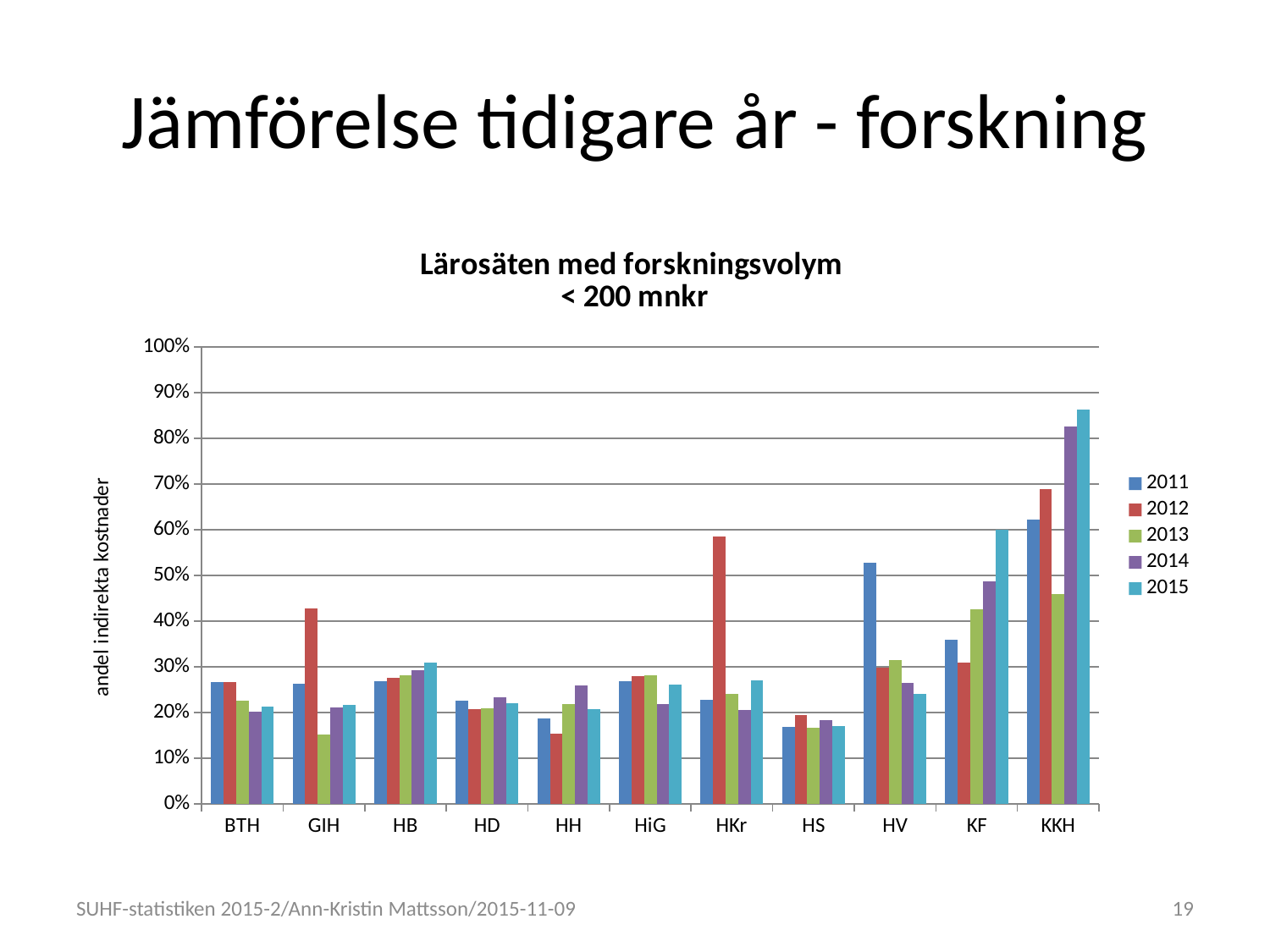
Is the value for HKr in 2012 greater or less than 50%? greater How many series does the legend list? 5 Is the value for KKH in 2015 greater or less than 80%? greater For KF, which is larger: the value for 2011 or the value for 2015? 2015 For HKr, which year has the highest value? 2012 Which institution and year has the highest bar in the chart? KKH, 2015 What kind of chart is shown on the slide? bar chart What is the title of the chart? Lärosäten med forskningsvolym < 200 mnkr How many institutions (categories) are shown on the x axis? 11 For HV, which is larger: the value for 2011 or the value for 2015? 2011 Is the value for GIH in 2013 greater or less than 20%? less